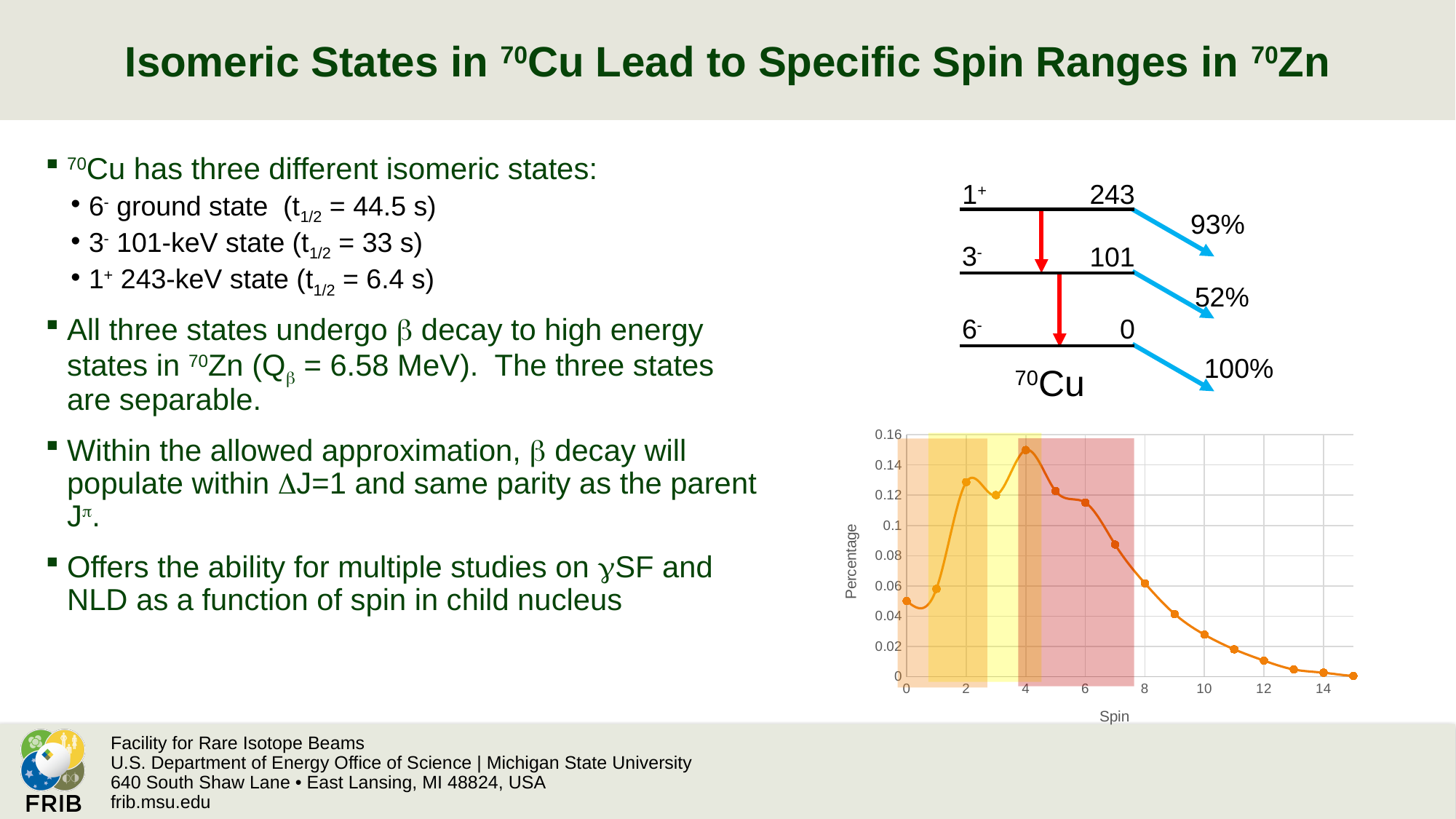
How many data points are plotted in the Percentage vs Spin chart? 16 What kind of chart is shown at the bottom right of the slide? line chart In the Percentage vs Spin chart, is the value at spin 0 greater or less than 0.06? less What is the label of the vertical axis of the chart at the bottom right? Percentage In the Percentage vs Spin chart, is the value at spin 8 greater or less than 0.08? less In the Percentage vs Spin chart, at which spin value does the curve reach its highest point? 4 In the Percentage vs Spin chart, do the values rise or fall as spin increases from 4 to 15? fall In the Percentage vs Spin chart, at which spin value is the plotted percentage lowest? 15 In the Percentage vs Spin chart, which has the larger percentage: spin 2 or spin 10? spin 2 In the Percentage vs Spin chart, is the value at spin 2 greater or less than 0.12? greater In the Percentage vs Spin chart, which has the larger percentage: spin 7 or spin 9? spin 7